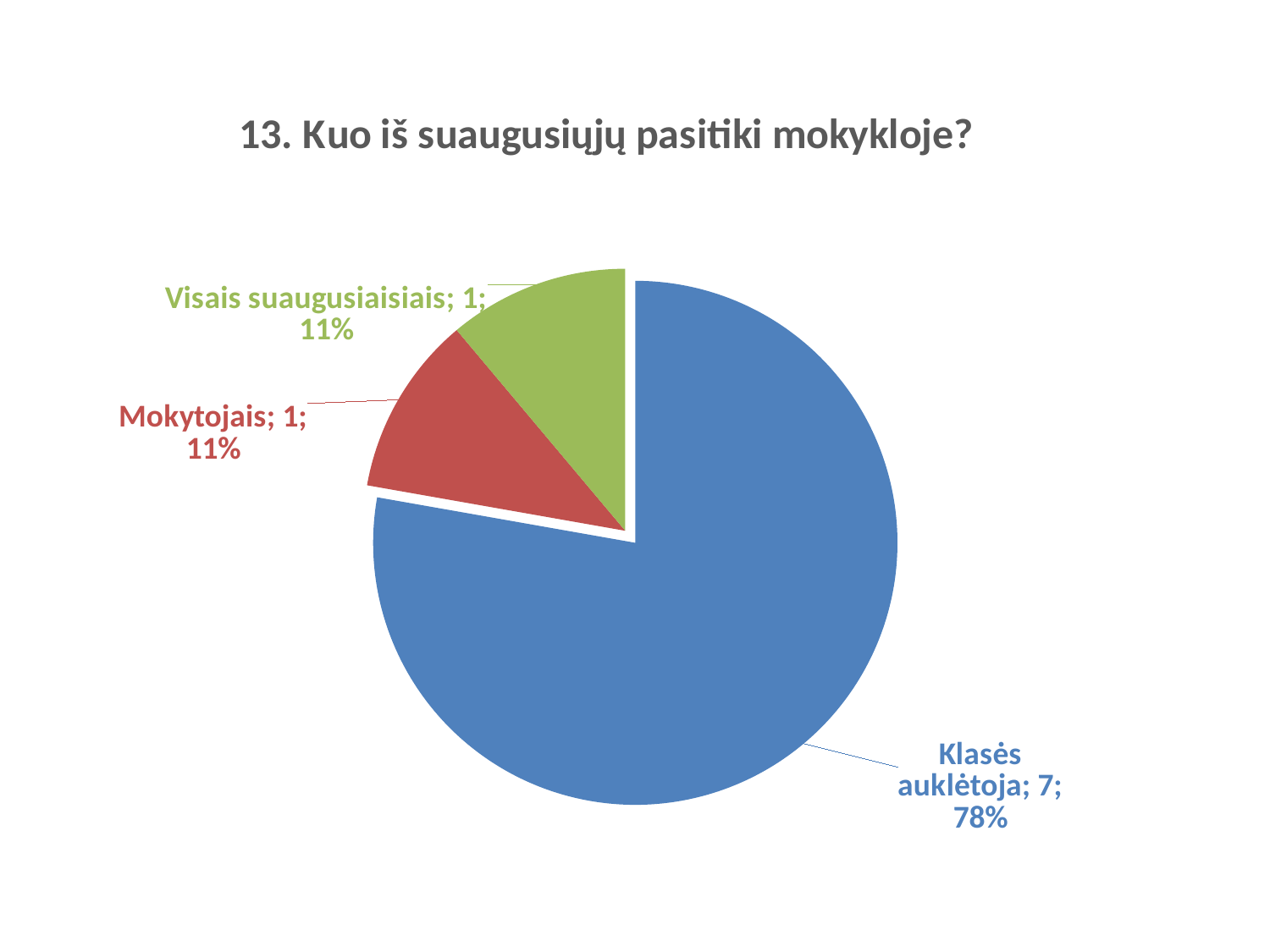
What is the difference between the values for Klasės auklėtoja and Mokytojais? 6 What is the title of the chart? 13. Kuo iš suaugusiųjų pasitiki mokykloje? What share of the pie does Mokytojais represent? 11% What is the value for Klasės auklėtoja? 7 What kind of chart is shown on the slide? pie chart What share of the pie does Klasės auklėtoja represent? 78% What colour is the Klasės auklėtoja slice? blue How many slices does the pie chart have? 3 What is the value for Visais suaugusiaisiais? 1 What is the total of all the values shown in the pie chart? 9 What is the value for Mokytojais? 1 Which category has the largest slice? Klasės auklėtoja